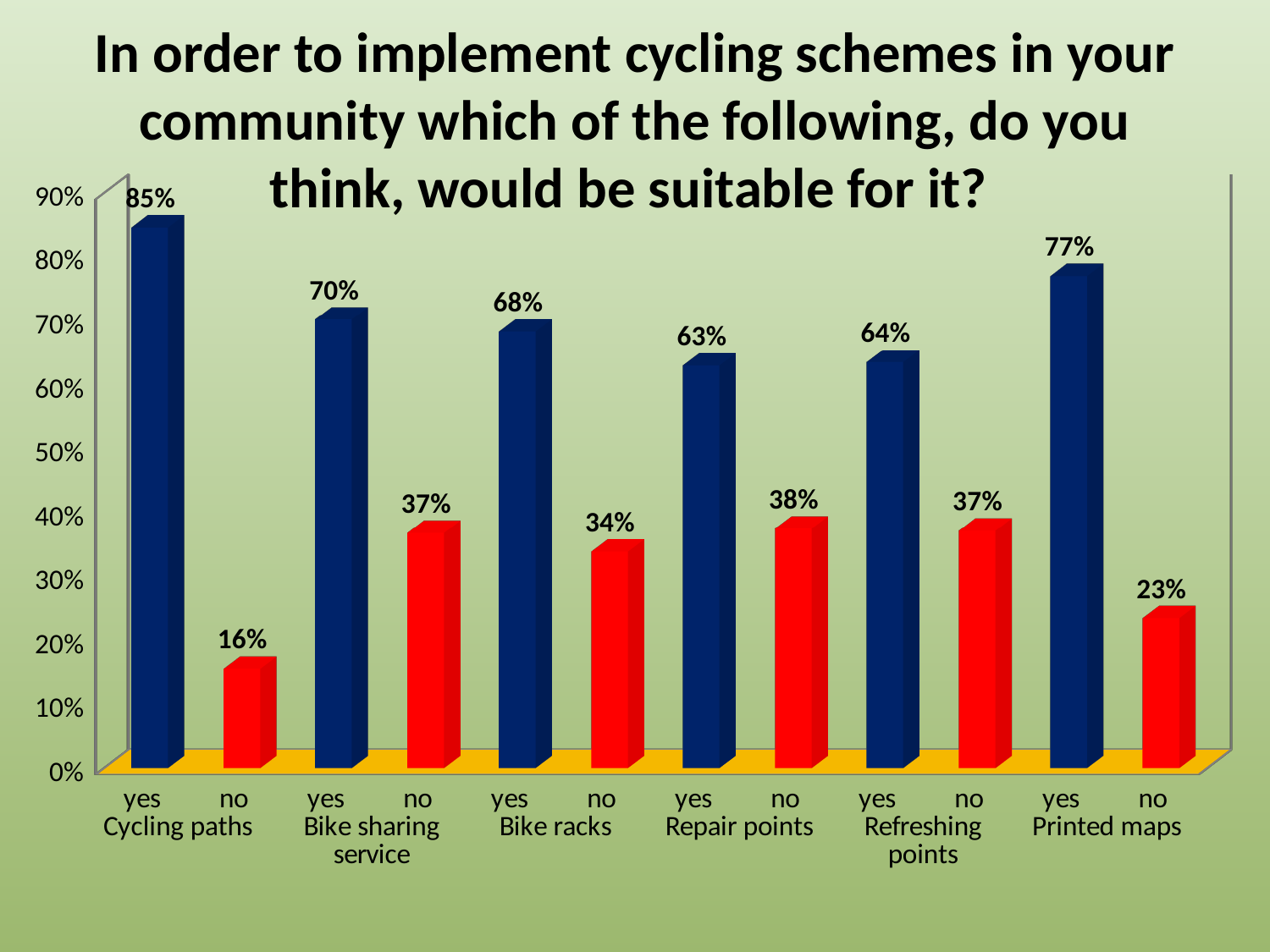
What colour are the bars representing 'no' responses? Red Is the no value for repair points greater or less than 30%? greater Which is larger, the yes value for bike racks or the yes value for refreshing points? Bike racks What is the yes value for repair points? 63% What kind of chart is shown on the slide? Bar chart Which option has the highest yes percentage? Cycling paths What percentage of respondents said no to printed maps? 23% How many options (categories) are shown on the chart? 6 Which option has the lowest no percentage? Cycling paths What is the difference between the yes and no values for bike sharing service? 33% What percentage of respondents said yes to cycling paths? 85% What is the difference between the yes values for cycling paths and printed maps? 8%